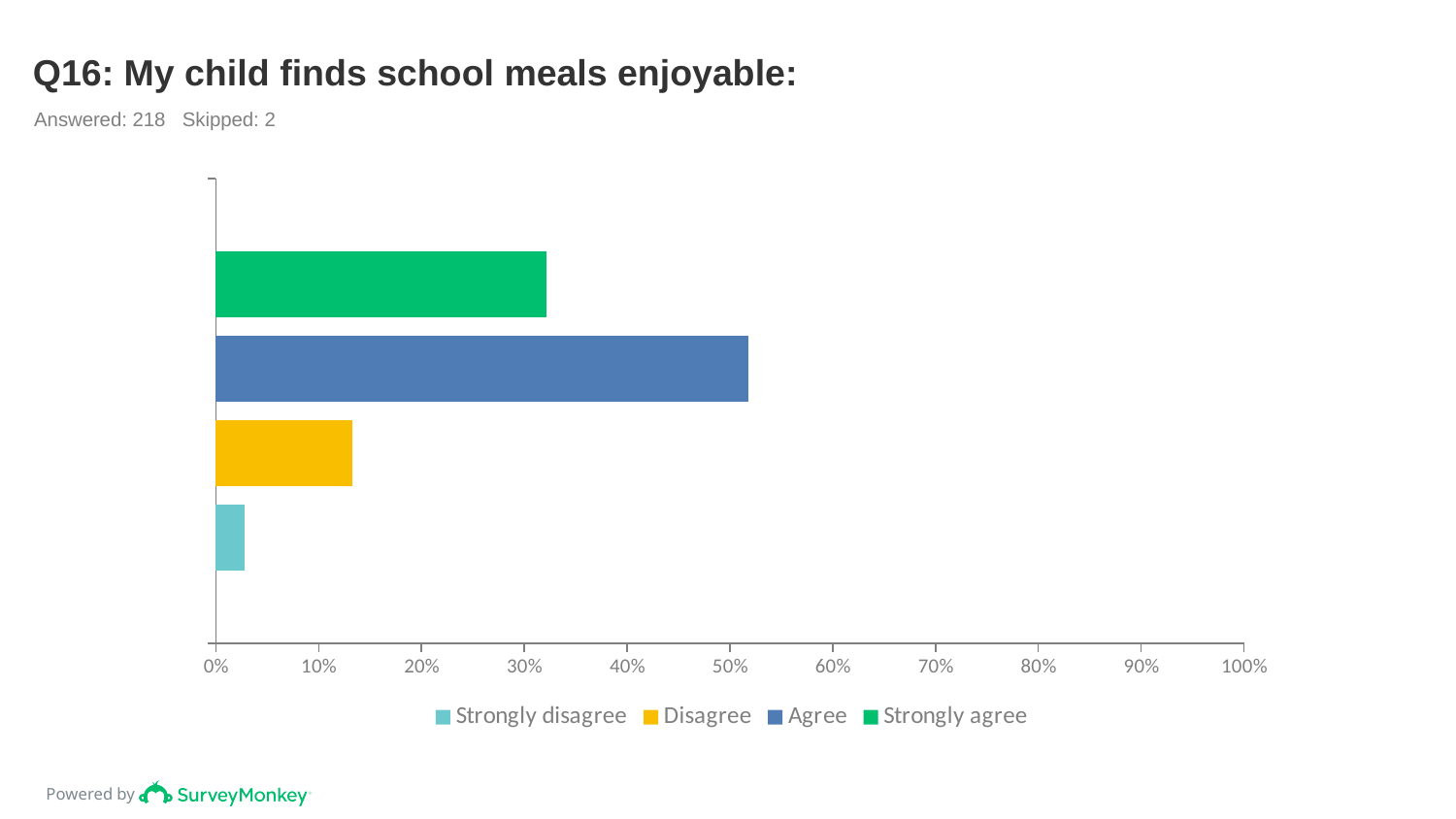
How many respondents answered the question according to the slide? 218 Which is larger, the value for Agree or the value for Strongly agree? Agree Which is larger, the value for Disagree or the value for Strongly disagree? Disagree Is the value for Strongly disagree greater or less than 10%? less What is the title of the chart? Q16: My child finds school meals enjoyable: Is the value for Disagree greater or less than 10%? greater How many series does the legend list? 4 Which response option has the longest bar? Agree Is the value for Strongly agree greater or less than 40%? less What kind of chart is shown on the slide? bar chart Which response option has the shortest bar? Strongly disagree